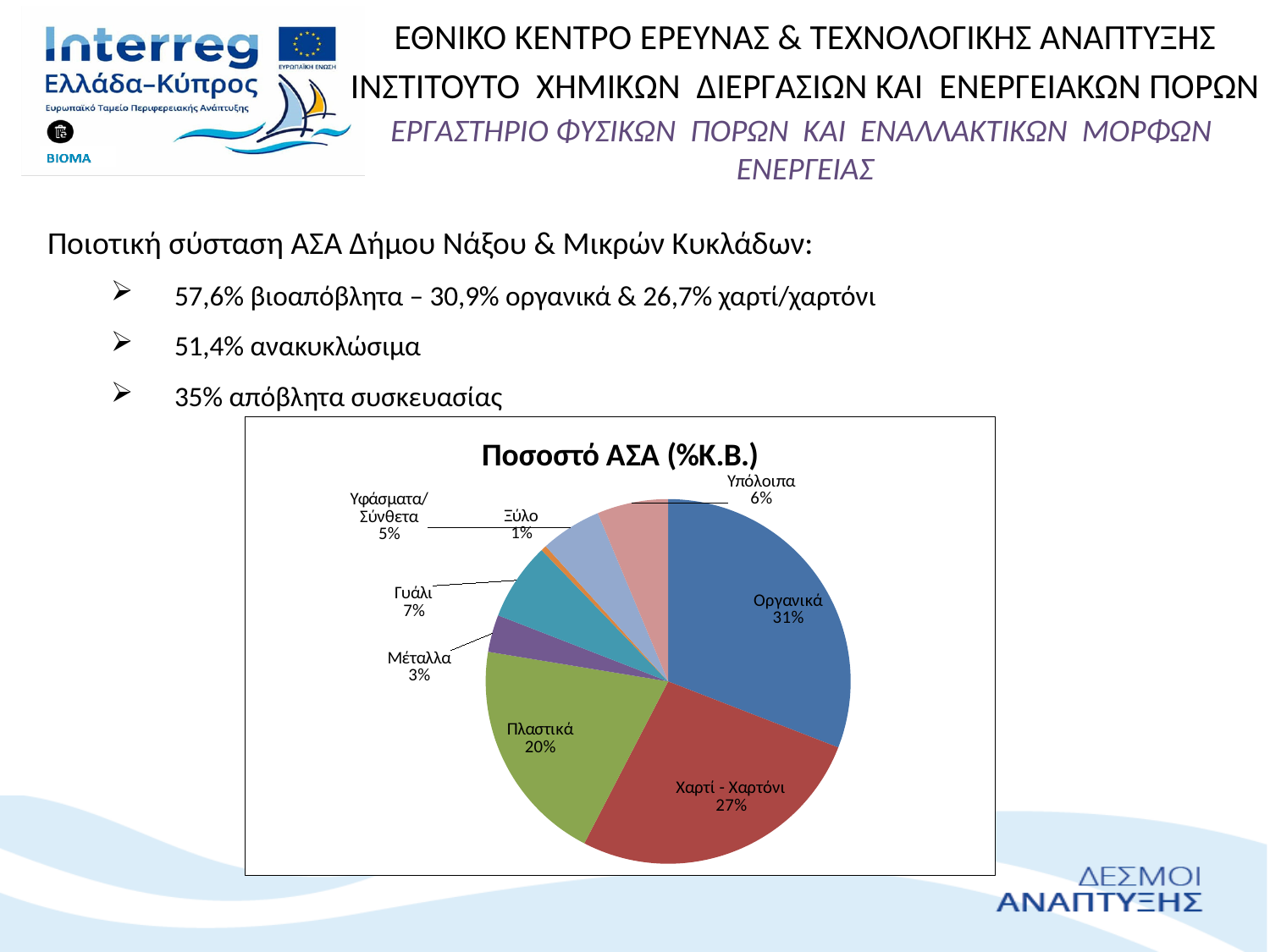
Which category has the smallest share of the pie? Ξύλο What percentage does the Οργανικά slice represent? 31% What is the difference in percentage points between Οργανικά and Πλαστικά? 11 What percentage does the Χαρτί - Χαρτόνι slice represent? 27% What percentage does the Πλαστικά slice represent? 20% Which is larger, the share for Μέταλλα or the share for Υπόλοιπα? Υπόλοιπα How many slices does the pie chart have? 8 What type of chart is shown on the slide? pie chart What percentage does the Υφάσματα/Σύνθετα slice represent? 5% What is the title of the chart? Ποσοστό ΑΣΑ (%Κ.Β.) Which category has the largest share of the pie? Οργανικά What percentage does the Γυάλι slice represent? 7%